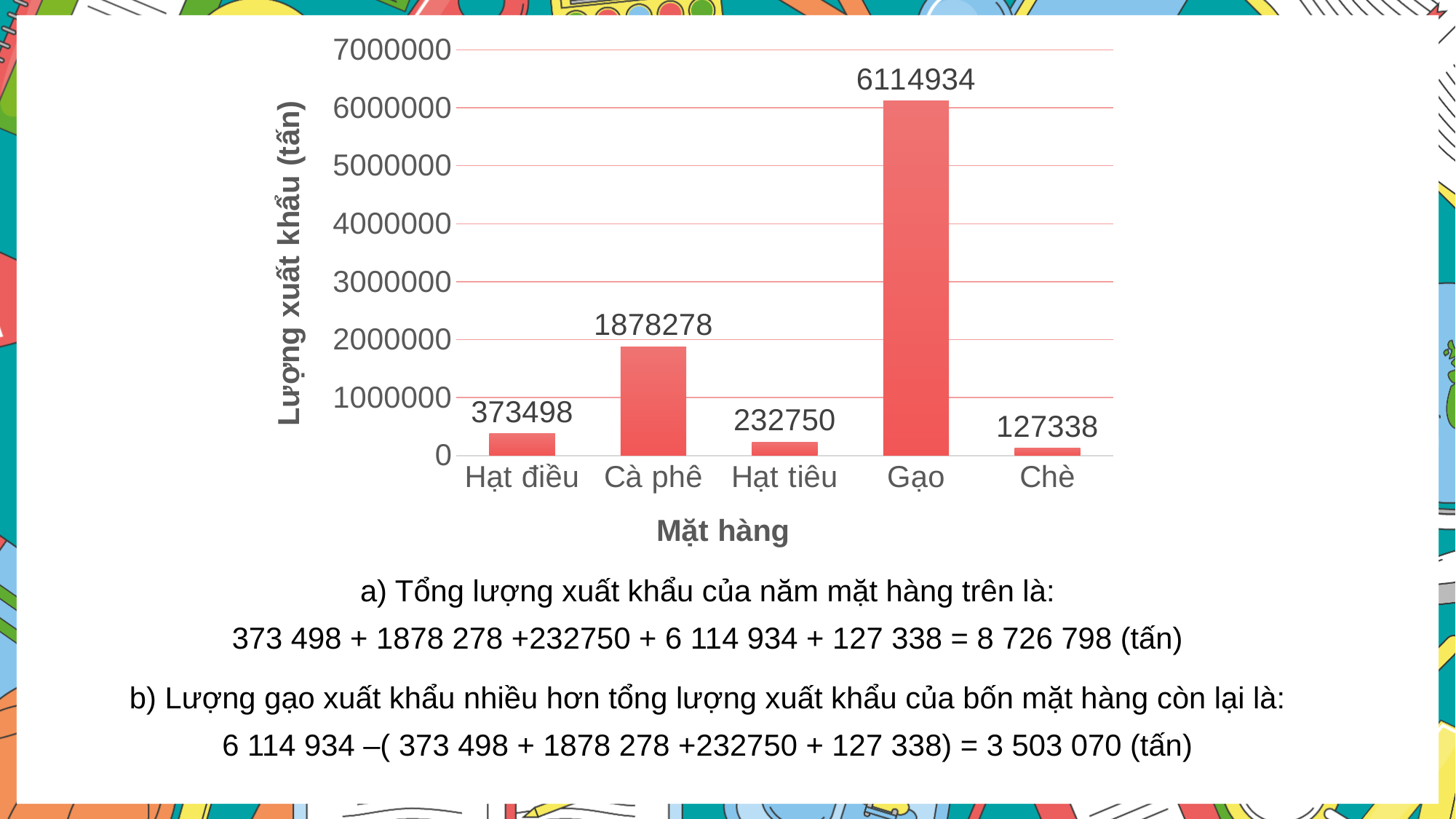
What is the export volume for Hạt tiêu? 232750 How many categories are shown on the x axis? 5 What is the difference between the export volumes of Gạo and Cà phê? 4236656 What is the export volume for Cà phê? 1878278 What is the difference between the export volumes of Hạt điều and Hạt tiêu? 140748 Which category has the highest export volume? Gạo What is the export volume for Gạo? 6114934 What kind of chart is shown on the slide? bar chart Is the value for Cà phê greater or less than 2000000? less Which category has the lowest export volume? Chè What is the export volume for Chè? 127338 Which has a larger export volume, Hạt điều or Chè? Hạt điều